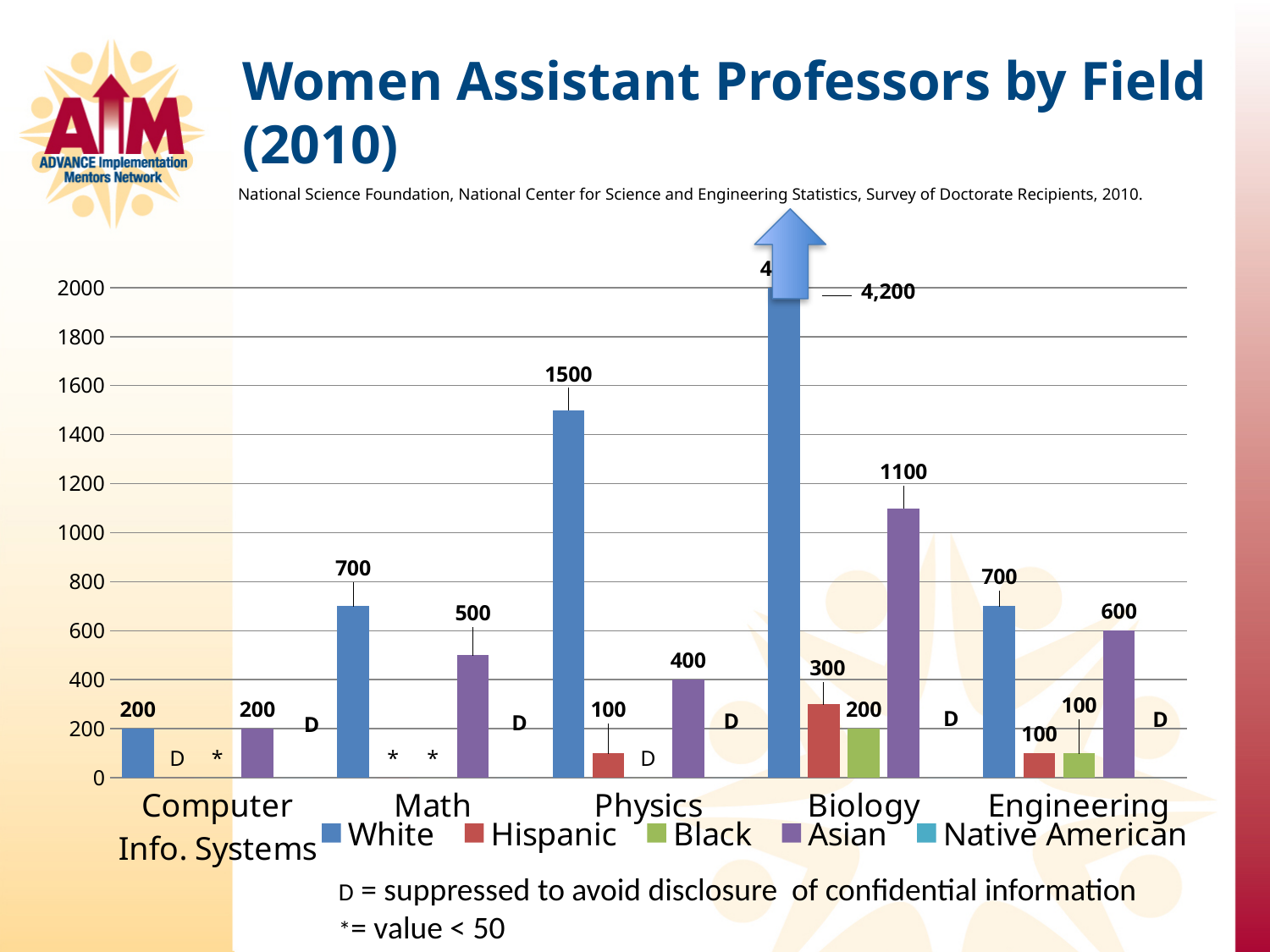
What is the difference between the Asian values for Biology and Engineering? 500 Which is larger, the Asian value for Engineering or the Asian value for Math? Engineering How many series does the legend list? 5 Which field has the highest value for Asian? Biology What is the value for Hispanic in Biology? 300 Which field has the lowest value for White? Computer Info. Systems How many fields are shown on the x axis? 5 What is the value for Asian in Biology? 1100 What kind of chart is shown on the slide? Bar chart What is the difference between the White and Asian values in Physics? 1100 What is the value for White in Physics? 1500 What is the value for White in Biology? 4,200